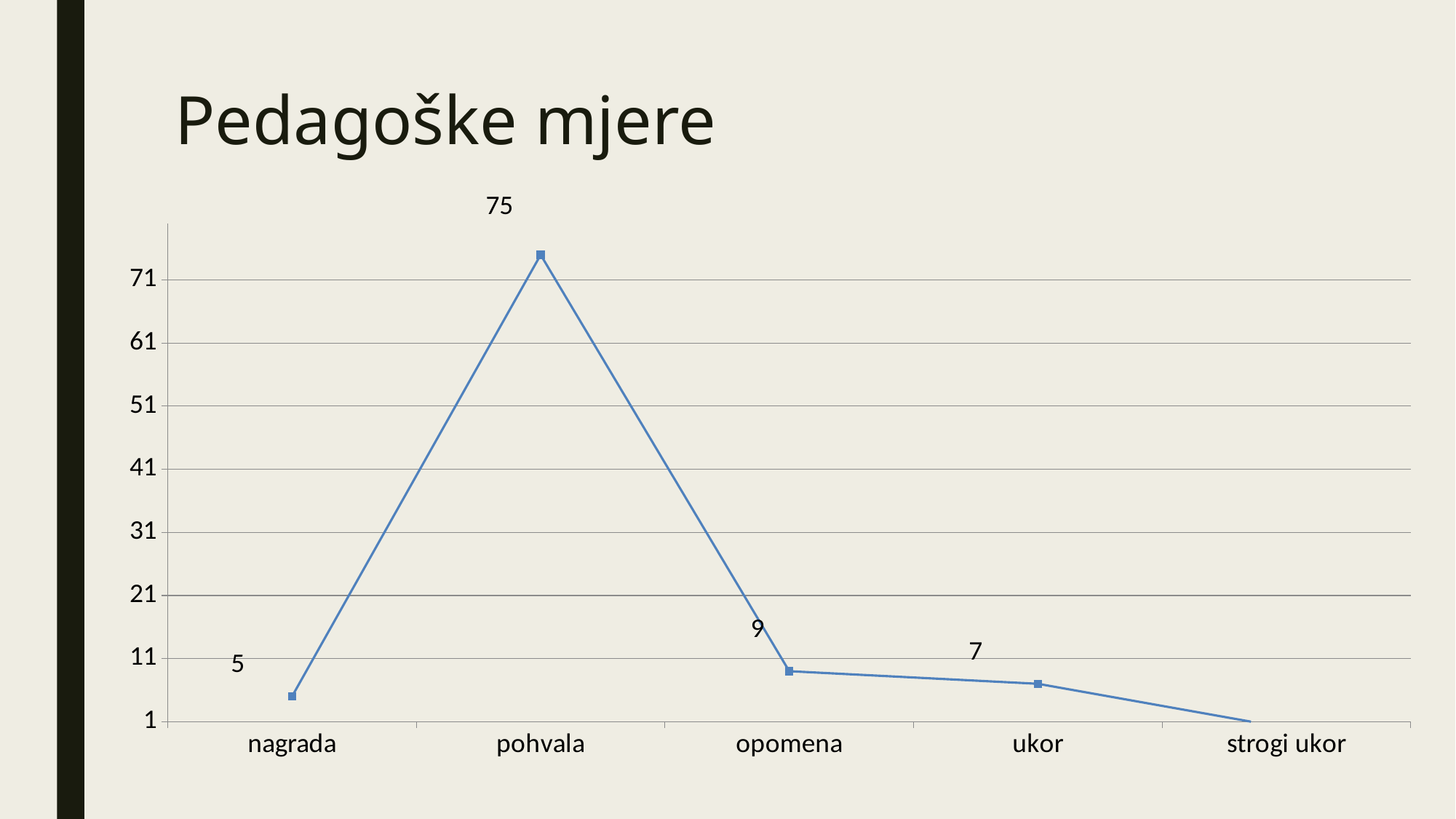
What is the value for opomena? 9 What is the value for nagrada? 5 What is the value for pohvala? 75 What is the value for ukor? 7 Is the value for strogi ukor greater or less than 11? less Which category has the highest value? pohvala What is the title of the slide? Pedagoške mjere What kind of chart is shown on the slide? line chart Which category has the lowest value? strogi ukor What is the difference between the values for pohvala and opomena? 66 How many categories are shown on the x axis? 5 Which is larger, the value for opomena or the value for ukor? opomena